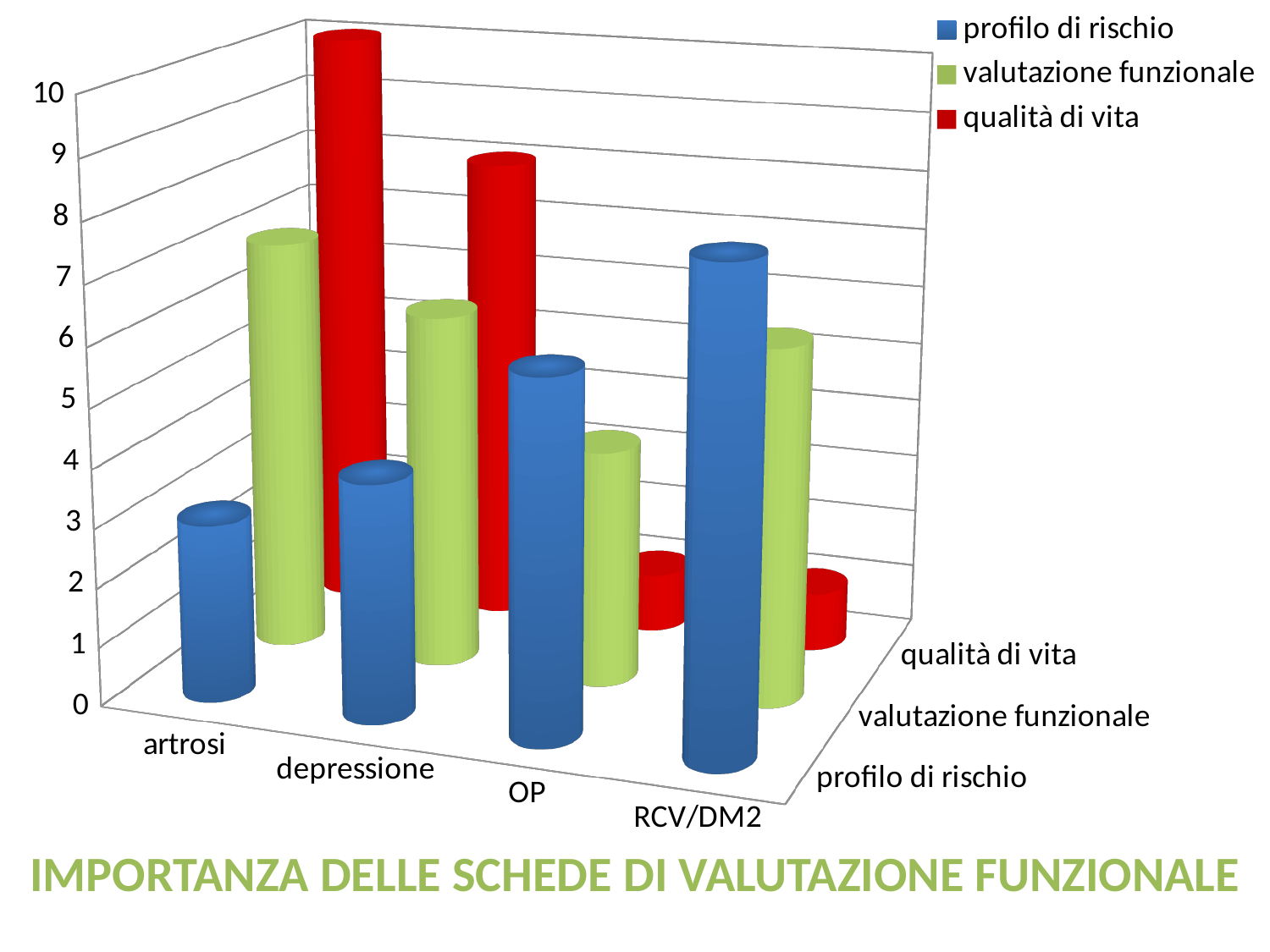
How many categories are shown along the x axis of the chart? 4 What kind of chart is shown on the slide? bar chart Which category has the highest value for the 'qualità di vita' series? artrosi Which category has the highest value for the 'profilo di rischio' series? RCV/DM2 For the 'qualità di vita' series, which is larger: the value for artrosi or the value for OP? artrosi How many series does the chart legend list? 3 Is the 'profilo di rischio' value for RCV/DM2 greater or less than 5? greater Do the values of the 'profilo di rischio' series rise or fall from artrosi to RCV/DM2 along the x axis? rise Which colour represents the 'qualità di vita' series in the chart? red Which category has the lowest value for the 'profilo di rischio' series? artrosi What is the title shown below the chart? IMPORTANZA DELLE SCHEDE DI VALUTAZIONE FUNZIONALE Is the 'qualità di vita' value for OP greater or less than 5? less